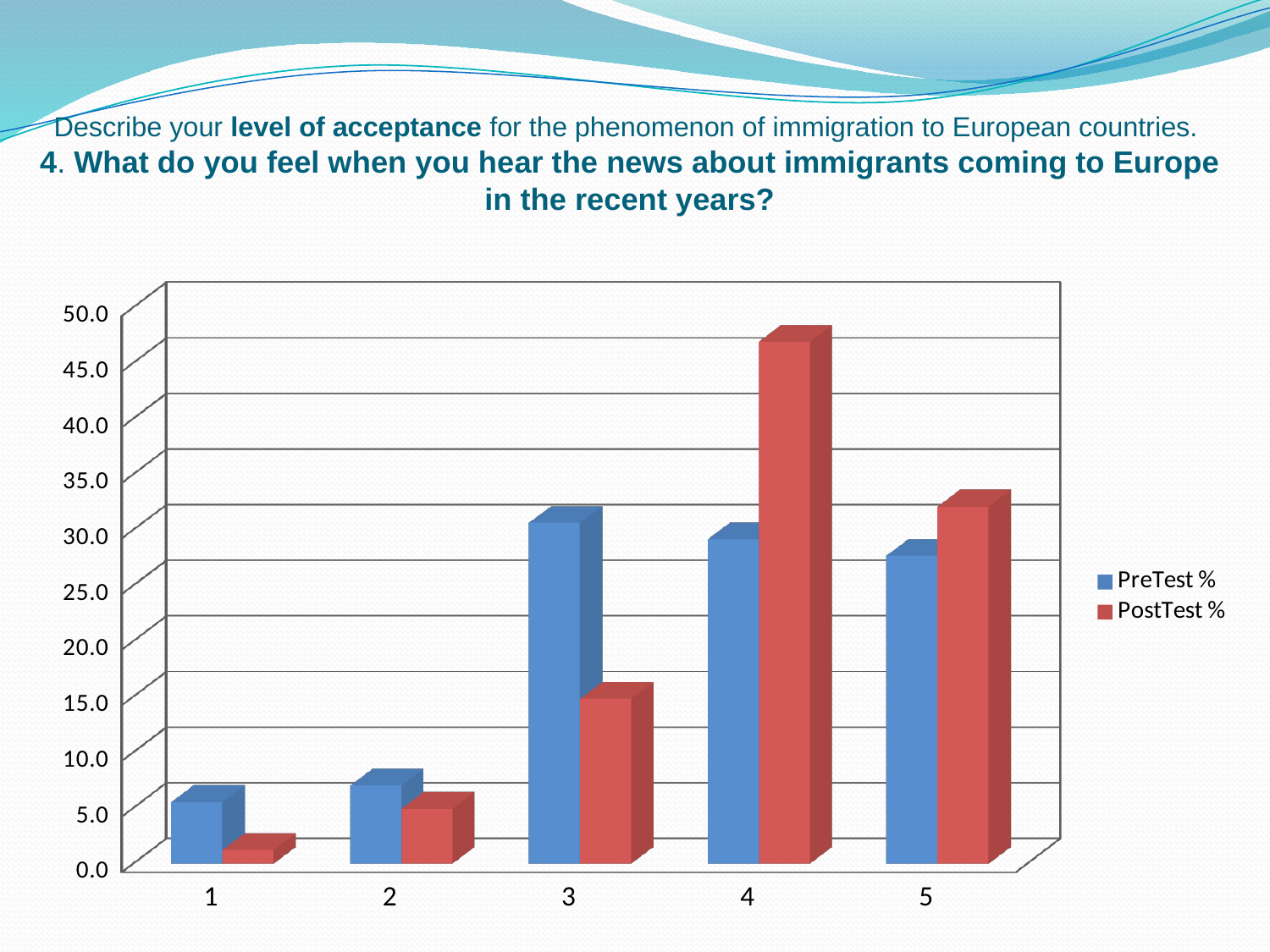
Which category has the lowest PostTest % value? 1 For category 4, which is larger, PreTest % or PostTest %? PostTest % What colour are the PostTest % bars? red Which category has the highest PostTest % value? 4 Which category has the lowest PreTest % value? 1 Is the PreTest % value for category 2 greater or less than 10.0? less What kind of chart is shown on the slide? bar chart How many series does the legend list? 2 For category 3, which is larger, PreTest % or PostTest %? PreTest % How many categories are shown on the x axis? 5 Is the PostTest % value for category 4 greater or less than 40.0? greater Is the PostTest % value for category 3 greater or less than 20.0? less